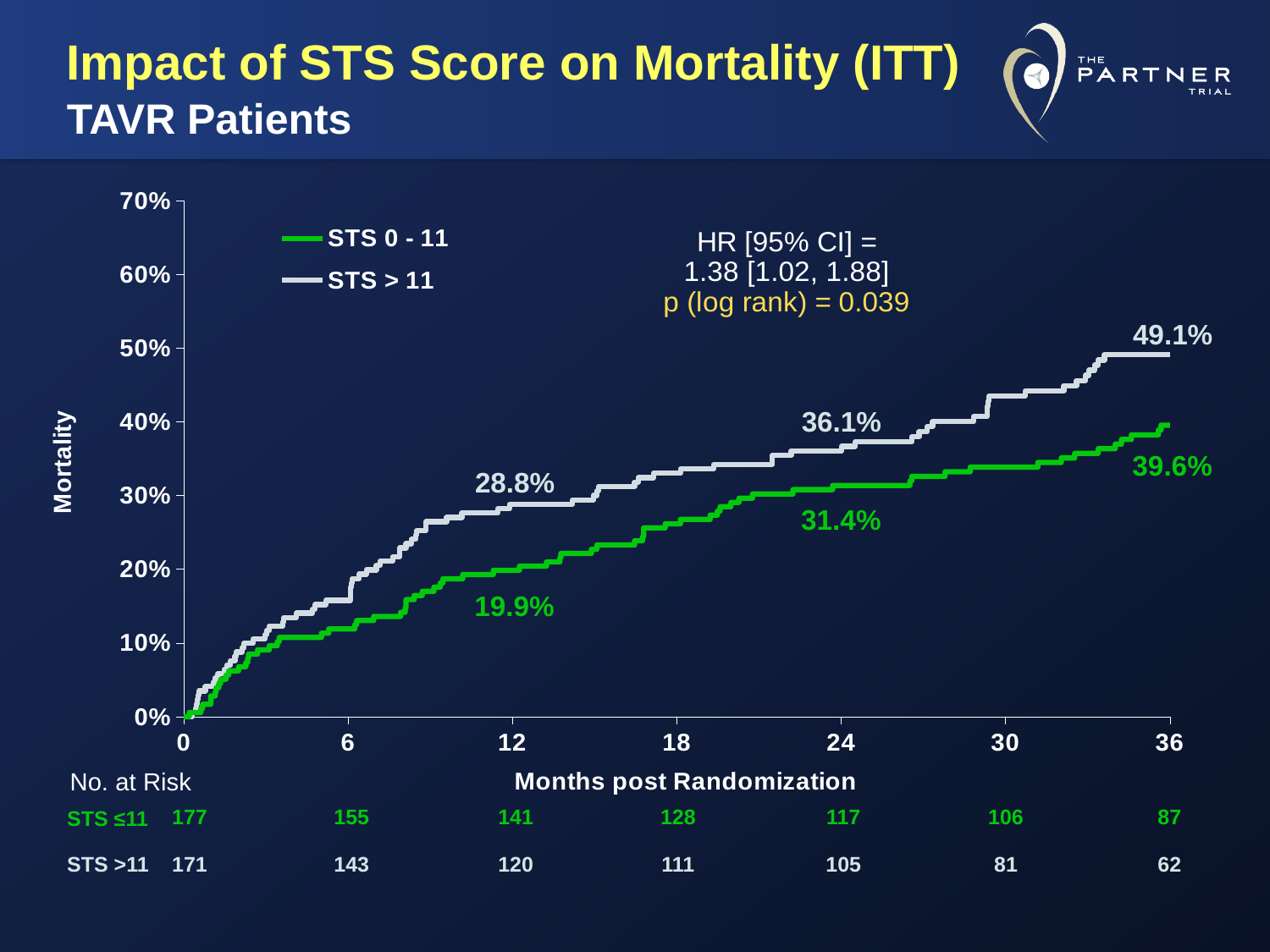
What is the mortality for STS > 11 at 36 months? 49.1% What is the mortality for STS 0 - 11 at 12 months? 19.9% What is the difference in mortality between STS > 11 and STS 0 - 11 at 36 months? 9.5% Is the mortality for STS 0 - 11 at 36 months greater or less than 40%? less What is the mortality for STS 0 - 11 at 36 months? 39.6% How many series does the legend list? 2 What is the difference in mortality between STS > 11 and STS 0 - 11 at 12 months? 8.9% Which group has higher mortality at 24 months, STS 0 - 11 or STS > 11? STS > 11 Do the mortality curves rise or fall over months post randomization? rise What is the mortality for STS > 11 at 24 months? 36.1% What is the number at risk for STS >11 at 36 months? 62 What is the p (log rank) value shown on the chart? 0.039